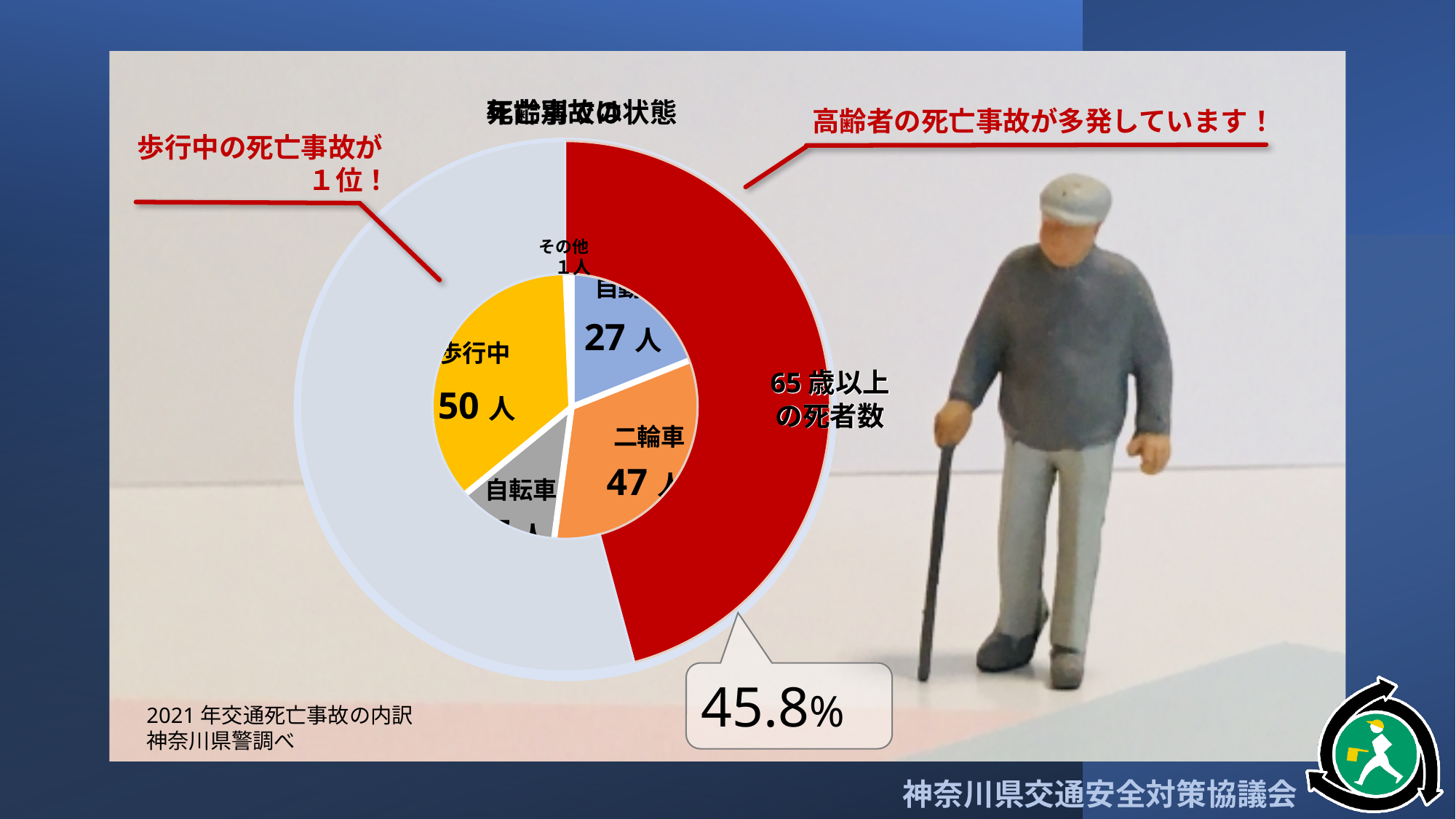
What share of the outer ring is labelled 65歳以上の死者数? 45.8% What is the value shown for 二輪車 in the inner pie chart? 47人 What kind of chart is shown on the slide? pie chart How many slices does the inner pie chart have? 5 What is the value shown for その他 in the inner pie chart? 1人 What is the difference between the values for 二輪車 and その他? 46人 What is the difference between the values for 歩行中 and 二輪車? 3人 Which category in the inner pie chart has the highest value? 歩行中 Which is larger, the value for 歩行中 or the value for 二輪車? 歩行中 What is the value shown for 歩行中 in the inner pie chart? 50人 What colour is the 歩行中 slice in the inner pie chart? yellow Which category in the inner pie chart has the lowest value? その他